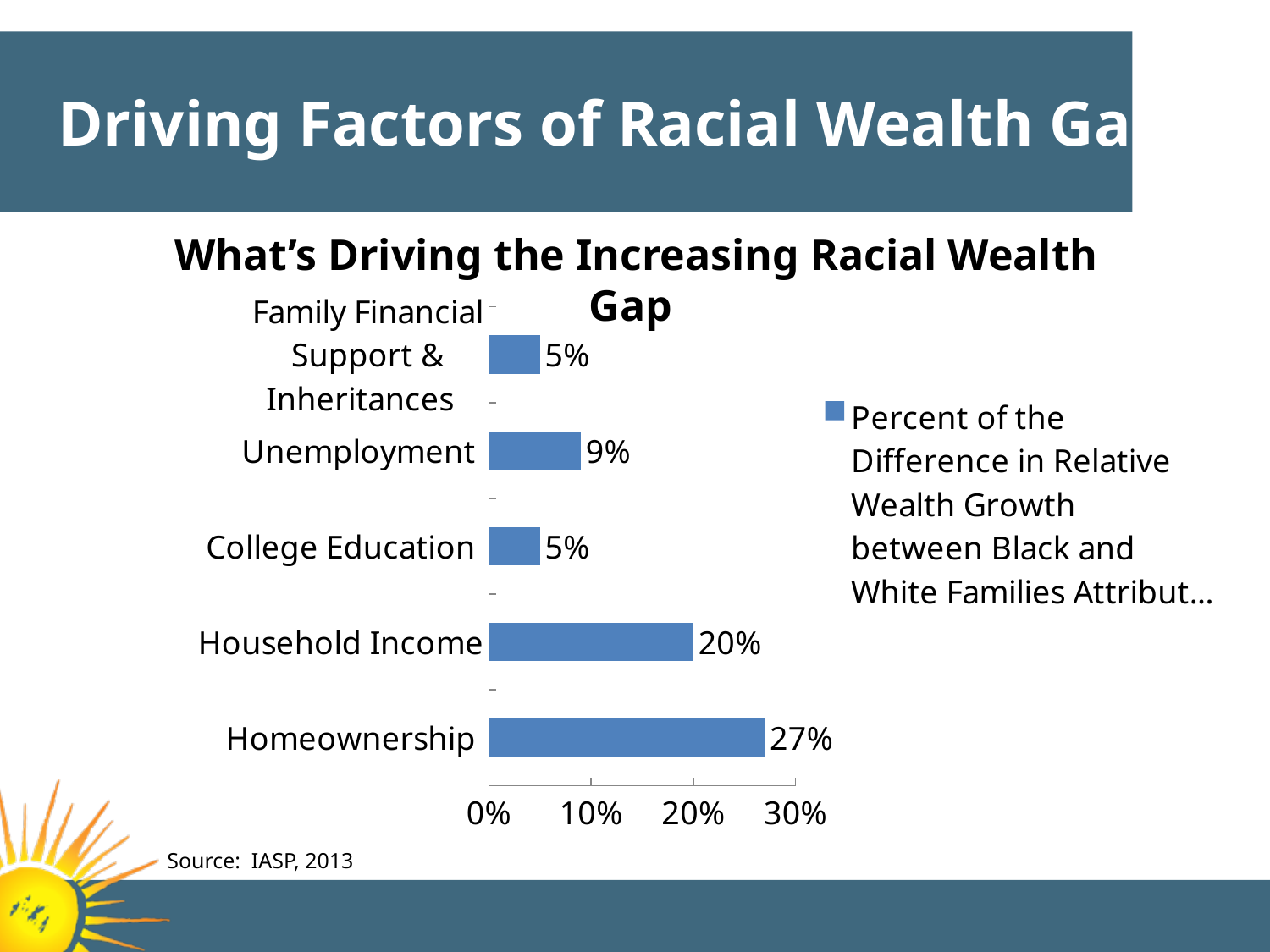
What is the value for Household Income? 20% What is the value for Unemployment? 9% Which is larger, the value for Unemployment or the value for College Education? Unemployment What is the source cited for the chart? IASP, 2013 What is the difference between the values for Unemployment and Family Financial Support & Inheritances? 4% Which category has the highest value? Homeownership Is the value for Household Income greater or less than 10%? greater What is the difference between the values for Homeownership and Household Income? 7% How many categories are shown in the chart? 5 What is the value for College Education? 5% What kind of chart is shown on the slide? Bar chart What is the value for Homeownership? 27%